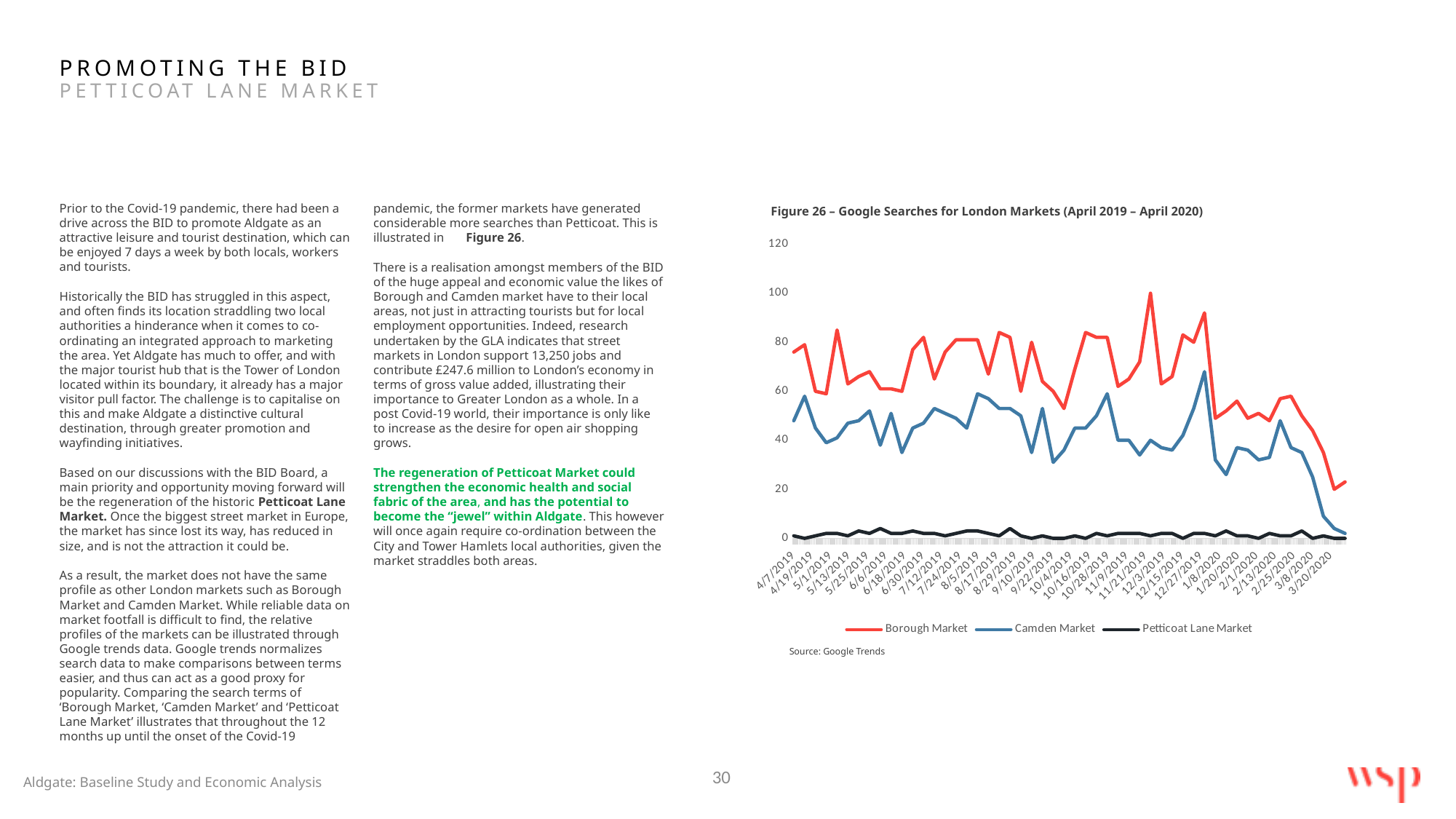
Which series in Figure 26 reaches the highest peak value? Borough Market Which series in Figure 26 is drawn in red? Borough Market Which series in Figure 26 has the lowest values throughout the period? Petticoat Lane Market Is the value for Borough Market at 3/20/2020 greater or less than 40? less Is the value for Petticoat Lane Market ever greater or less than 20 in Figure 26? less What kind of chart is Figure 26? Line chart How many series does the legend of Figure 26 list? 3 At 4/7/2019, which is larger in Figure 26: Borough Market or Camden Market? Borough Market Do the Borough Market values rise or fall between 2/25/2020 and 3/20/2020 in Figure 26? fall What is the title of the chart on the slide? Figure 26 – Google Searches for London Markets (April 2019 – April 2020) Is the peak value for Camden Market in Figure 26 greater or less than 60? greater